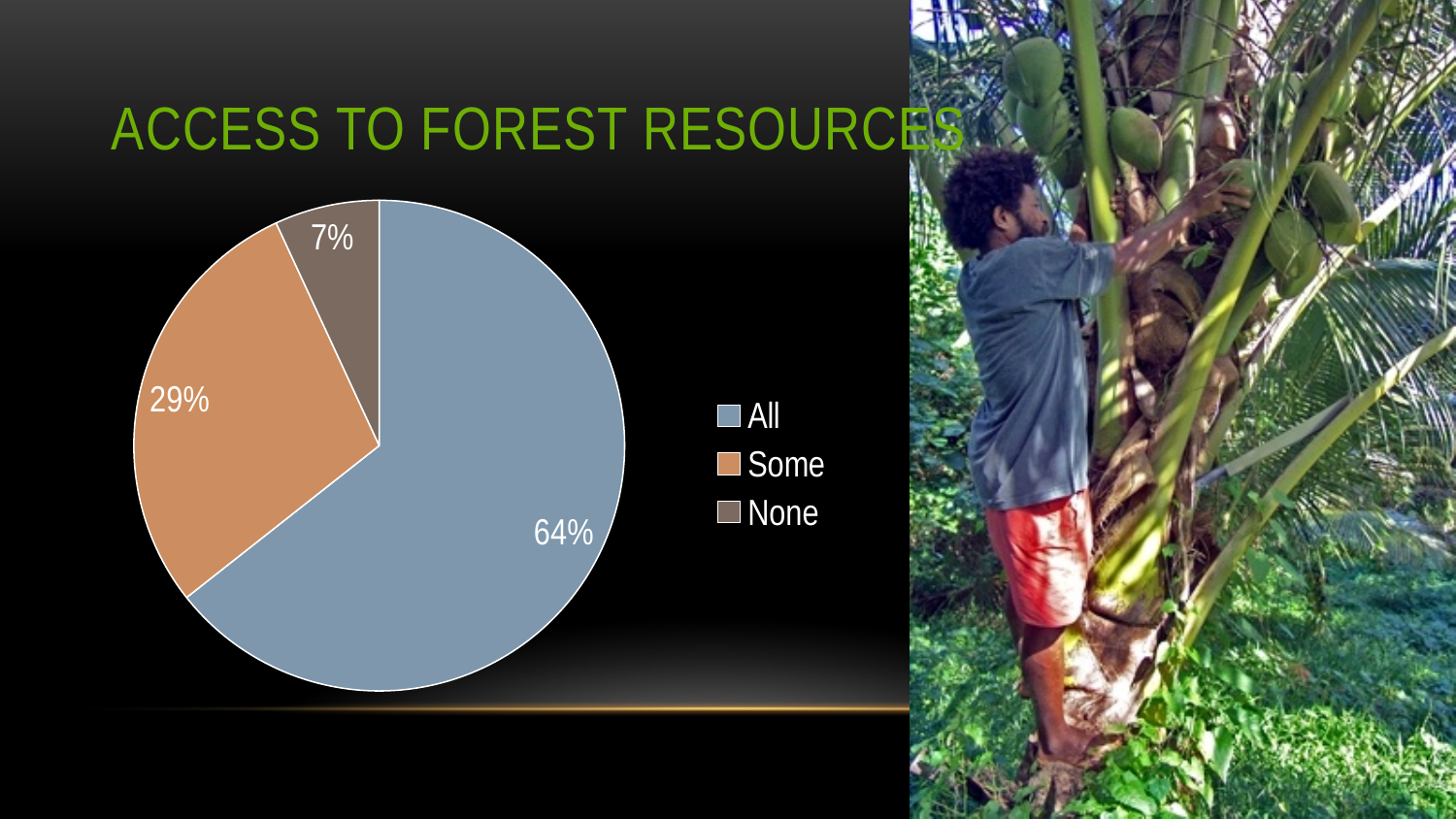
What kind of chart is shown on the slide? pie chart Which slice is larger, "Some" or "None"? Some How many slices does the pie chart have? 3 Which category has the largest share of the pie? All What is the title of the slide containing the pie chart? ACCESS TO FOREST RESOURCES What percentage of the pie is labelled "All"? 64% What percentage of the pie is labelled "None"? 7% Which category has the smallest share of the pie? None What percentage of the pie is labelled "Some"? 29% How many entries does the legend list? 3 What colour is the "Some" slice in the pie chart? orange/tan What is the difference in percentage points between the "All" slice and the "Some" slice? 35